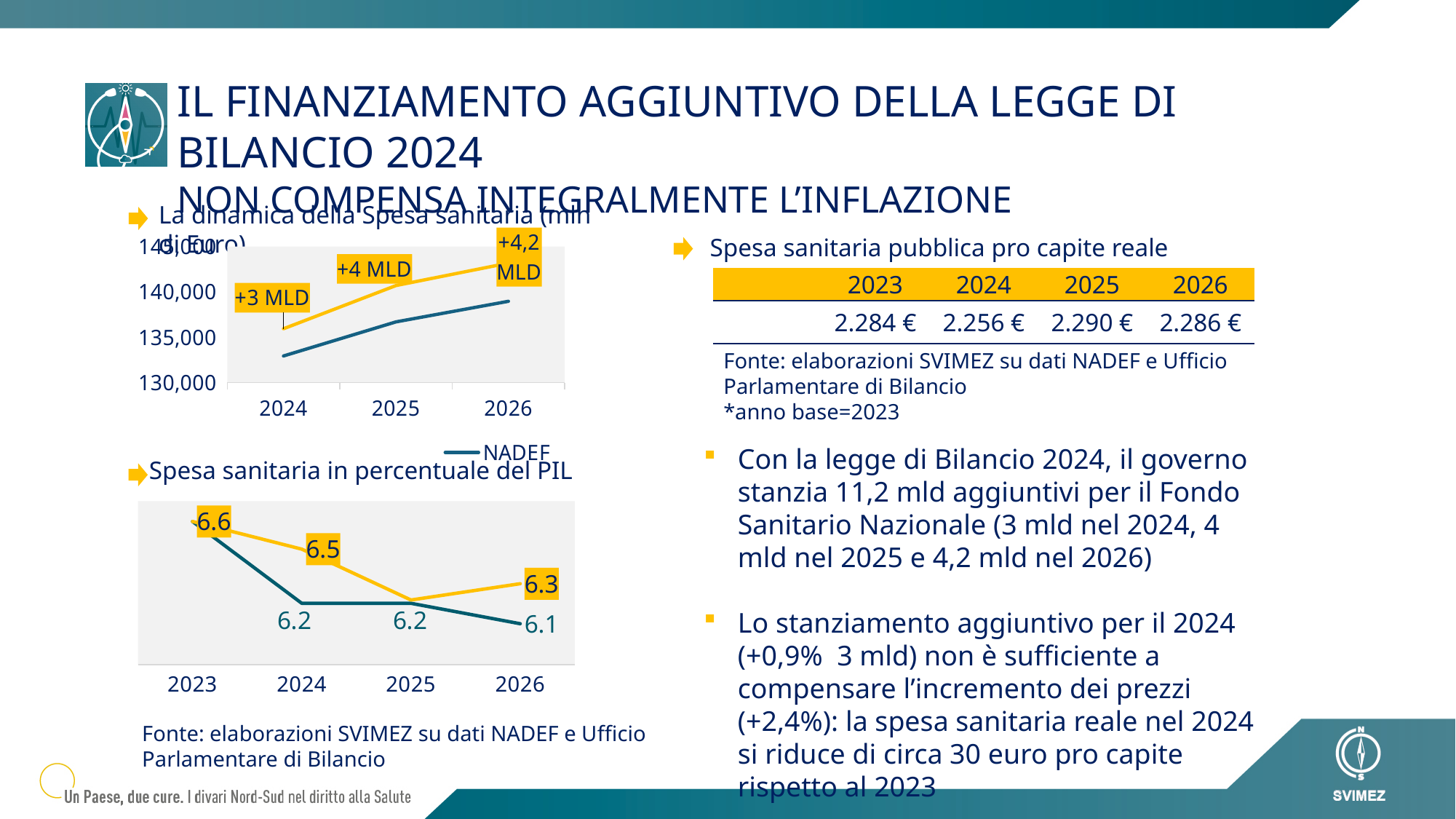
In the 'Spesa sanitaria in percentuale del PIL' chart, what is the value of the dark teal line for 2026? 6.1 What kind of chart is the 'Spesa sanitaria in percentuale del PIL' chart? line chart In the 'Spesa sanitaria in percentuale del PIL' chart, does the dark teal line rise or fall from 2023 to 2026? fall In the 'Spesa sanitaria in percentuale del PIL' chart, what is the value shown for 2023? 6.6 In the 'Spesa sanitaria in percentuale del PIL' chart, in which year is the dark teal line lowest? 2026 In the 'Spesa sanitaria in percentuale del PIL' chart, what is the value of the yellow line for 2026? 6.3 In the 'La dinamica della Spesa sanitaria' chart, what label is shown on the yellow line at 2025? +4 MLD In the 'Spesa sanitaria in percentuale del PIL' chart, what is the difference between the yellow line and the dark teal line in 2026? 0.2 In the 'La dinamica della Spesa sanitaria' chart, is the NADEF value for 2024 greater or less than 135,000? less In the 'Spesa sanitaria in percentuale del PIL' chart, how many years are shown on the x axis? 4 In the 'Spesa sanitaria in percentuale del PIL' chart, what is the difference between the yellow line and the dark teal line in 2024? 0.3 In the 'Spesa sanitaria in percentuale del PIL' chart, what is the value of the yellow line for 2024? 6.5